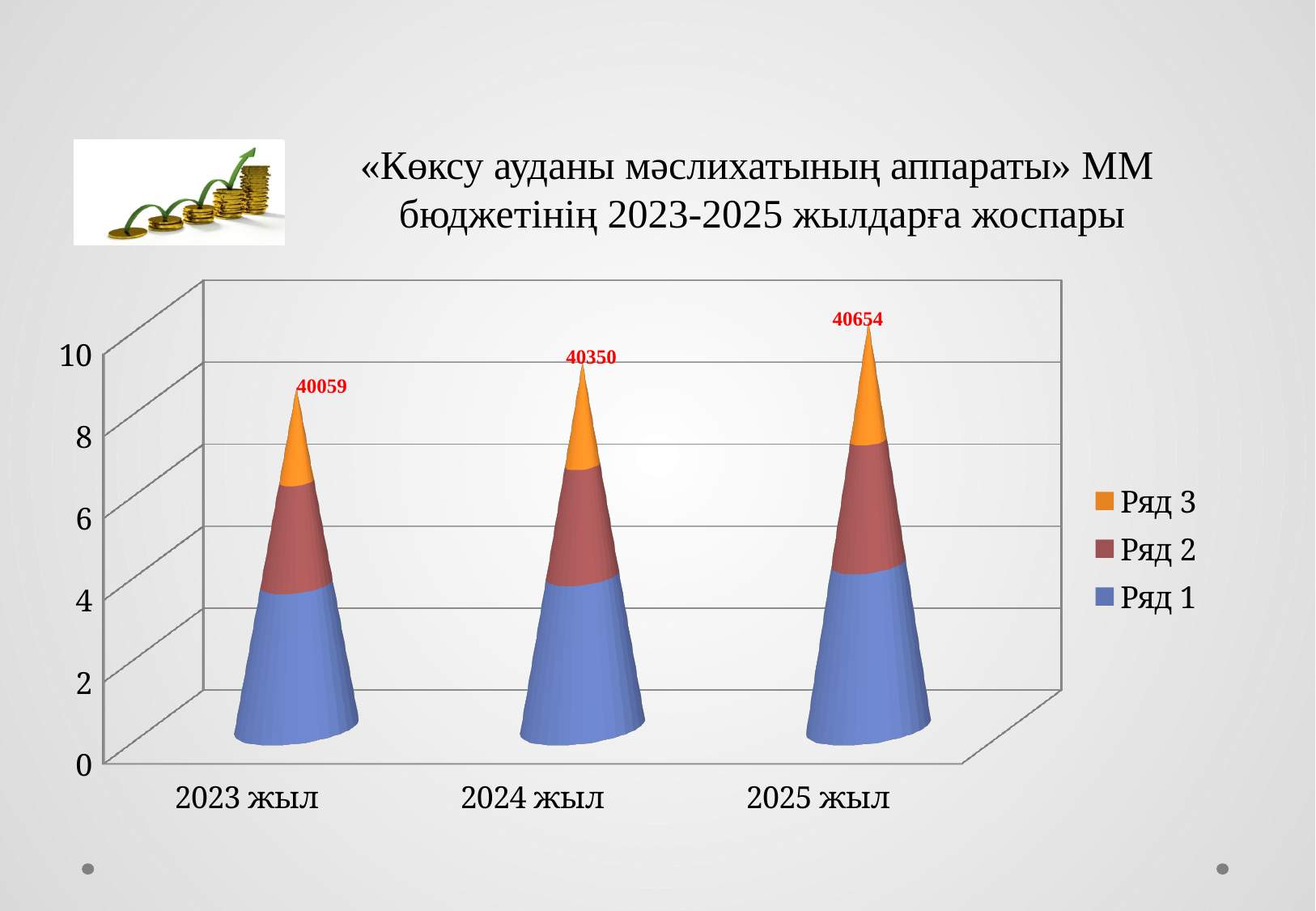
What is the difference between the labelled values for 2025 жыл and 2023 жыл? 595 How many series does the legend list? 3 How many years (categories) are shown on the x axis? 3 What value is labelled above the 2023 жыл bar? 40059 Which year has the lowest labelled value? 2023 жыл Which year has the highest labelled value? 2025 жыл What kind of chart is shown on the slide? Stacked bar chart Which is larger, the labelled value for 2024 жыл or for 2025 жыл? 2025 жыл What is the difference between the labelled values for 2024 жыл and 2023 жыл? 291 What value is labelled above the 2025 жыл bar? 40654 Do the labelled values rise or fall from 2023 жыл to 2025 жыл? Rise What value is labelled above the 2024 жыл bar? 40350